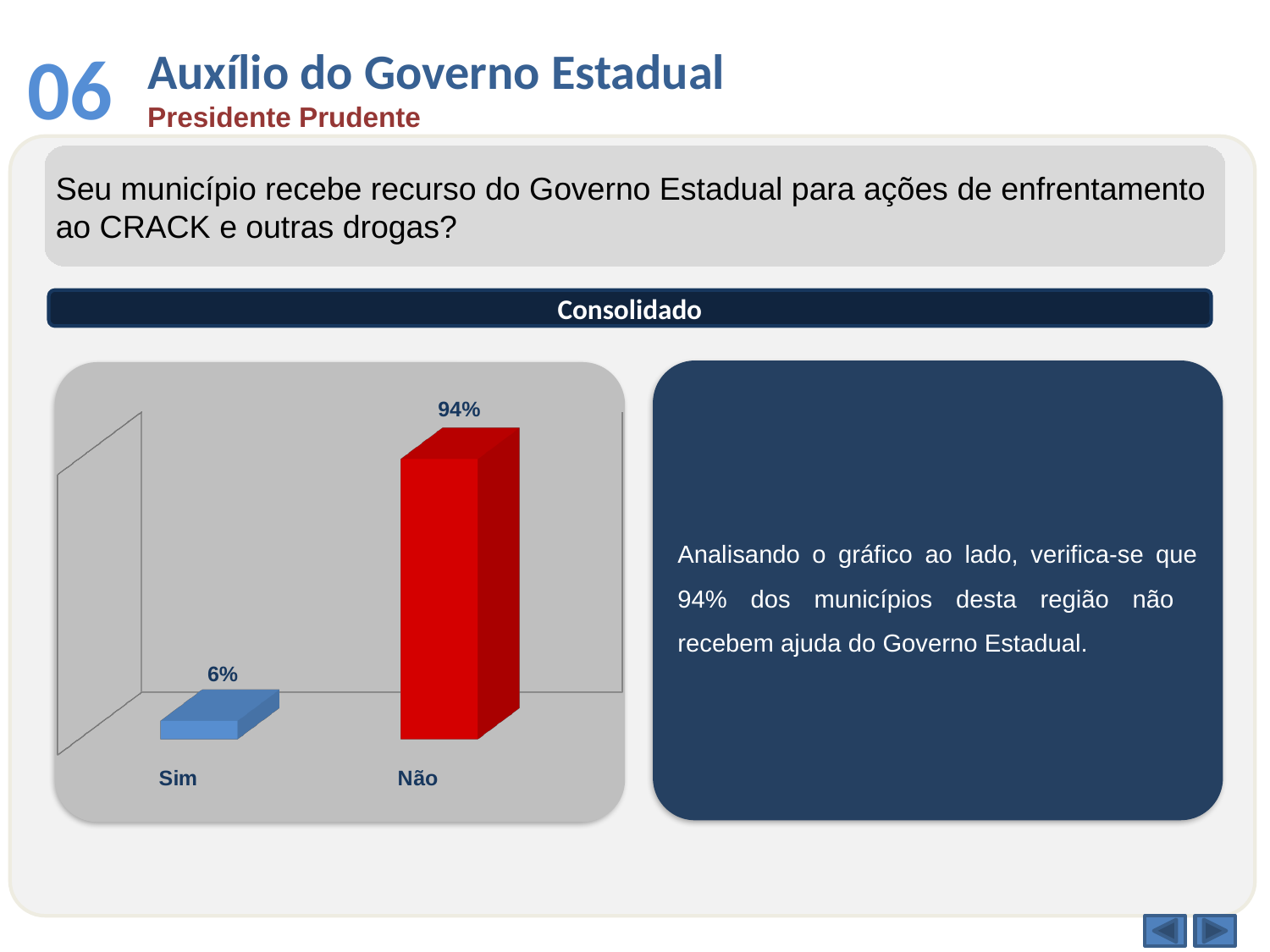
How many categories are shown in the chart? 2 What is the value for "Sim"? 6% Which category has the lowest value? Sim Which category has the highest value? Não What kind of chart is shown on the slide? Bar chart What is the value for "Não"? 94% What colour is the bar for "Não"? Red Which is larger, the value for "Sim" or the value for "Não"? Não What colour is the bar for "Sim"? Blue What is the total of the two values shown in the chart? 100% What is the difference between the values for "Não" and "Sim"? 88%